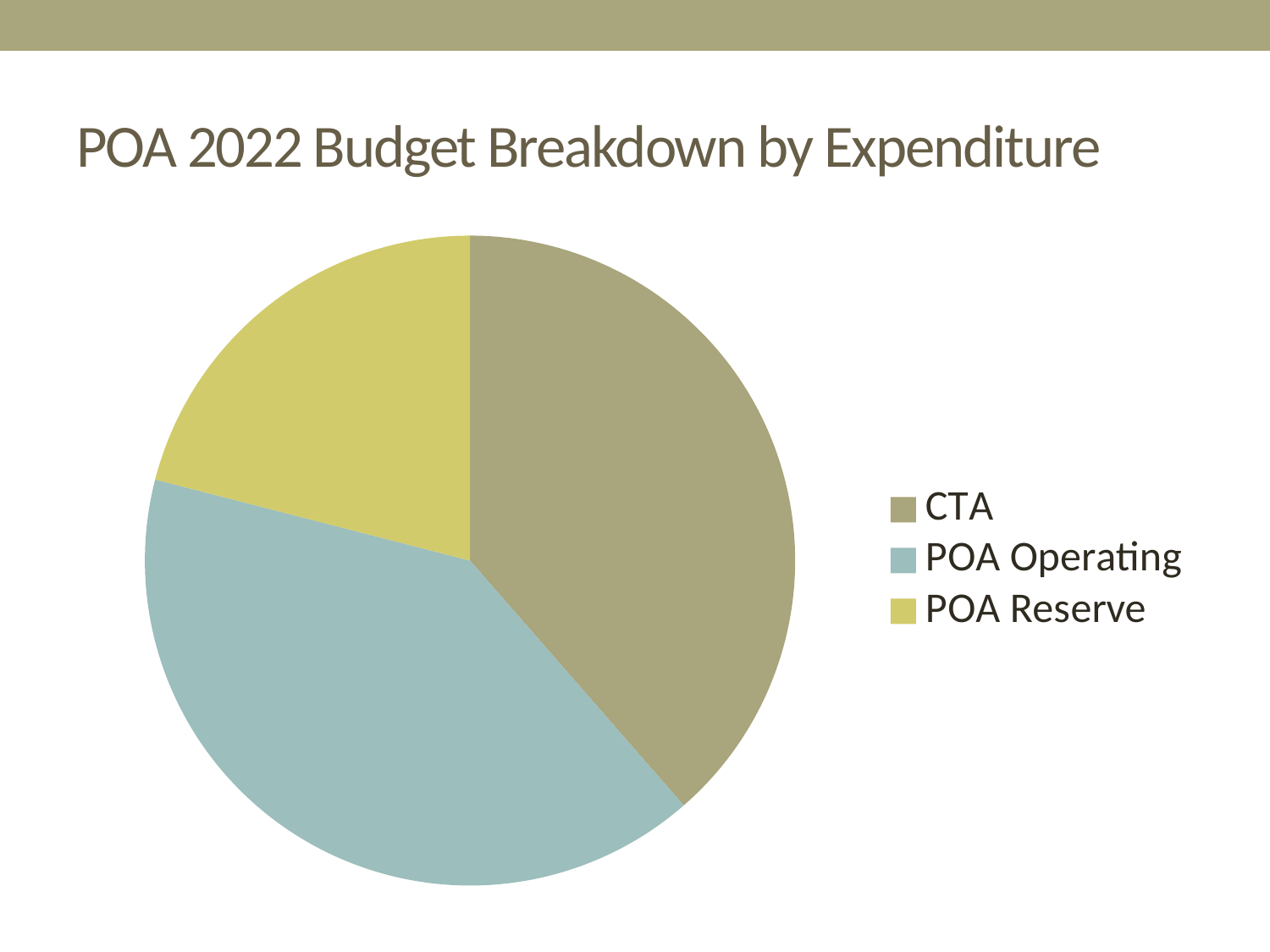
Which slice is larger, POA Operating or POA Reserve? POA Operating What is the title of the slide containing the pie chart? POA 2022 Budget Breakdown by Expenditure Which category has the smallest slice of the pie? POA Reserve What kind of chart is shown on the slide? Pie chart Which category is shown in the yellow slice of the pie chart? POA Reserve Which slice is larger, CTA or POA Reserve? CTA How many entries does the legend list? 3 How many slices does the pie chart have? 3